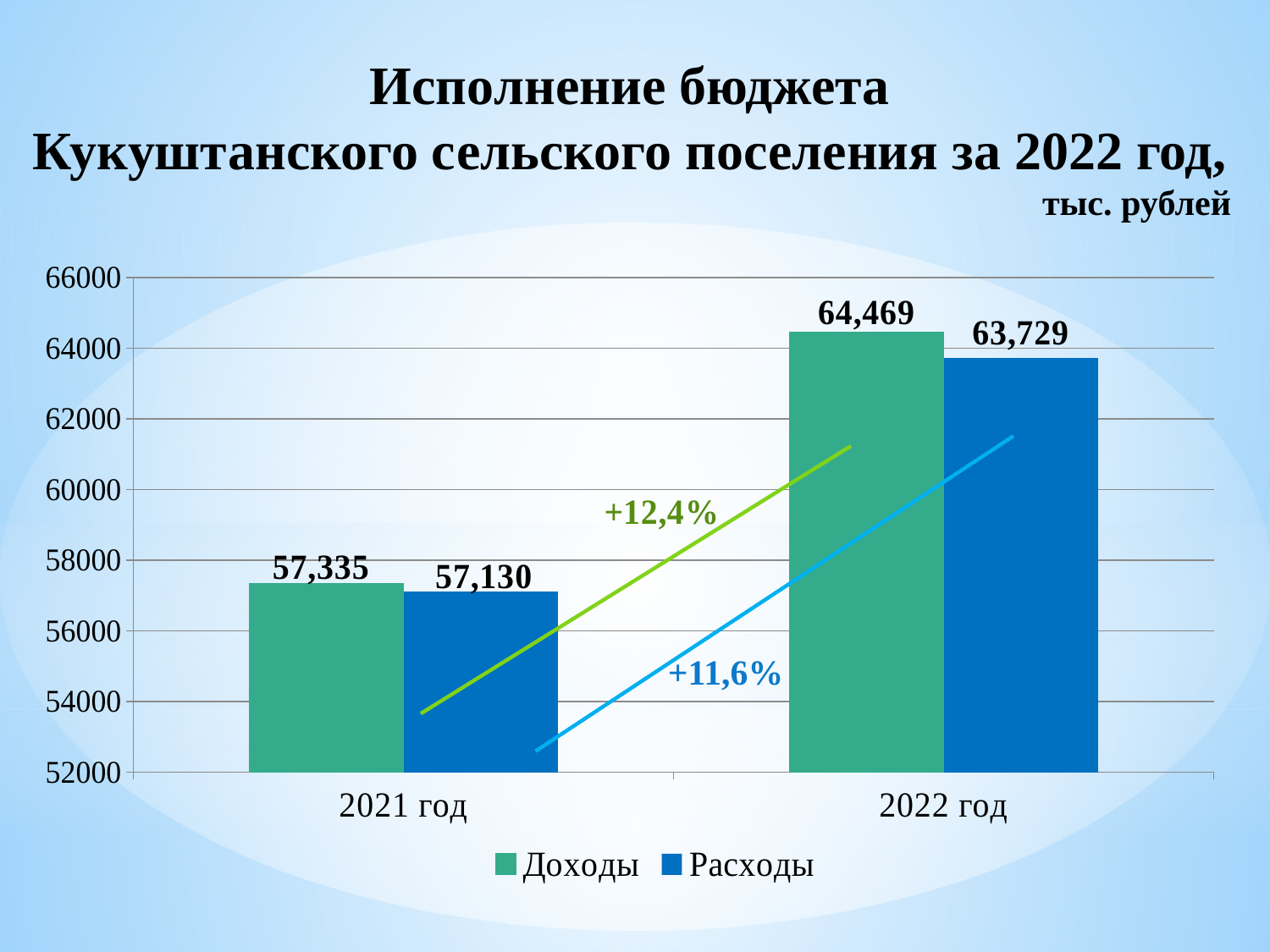
What is the difference between Доходы and Расходы in 2022 год? 740 What is the value of Доходы for 2022 год? 64,469 What is the value of Расходы for 2022 год? 63,729 Which bar has the highest value on the chart? Доходы, 2022 год What kind of chart is shown on the slide? Bar chart What is the difference between Доходы in 2022 год and Доходы in 2021 год? 7,134 What is the value of Доходы for 2021 год? 57,335 What percentage growth is shown for Расходы from 2021 год to 2022 год? +11,6% Which is larger in 2021 год: Доходы or Расходы? Доходы Which bar has the lowest value on the chart? Расходы, 2021 год How many series does the legend list? 2 What is the value of Расходы for 2021 год? 57,130